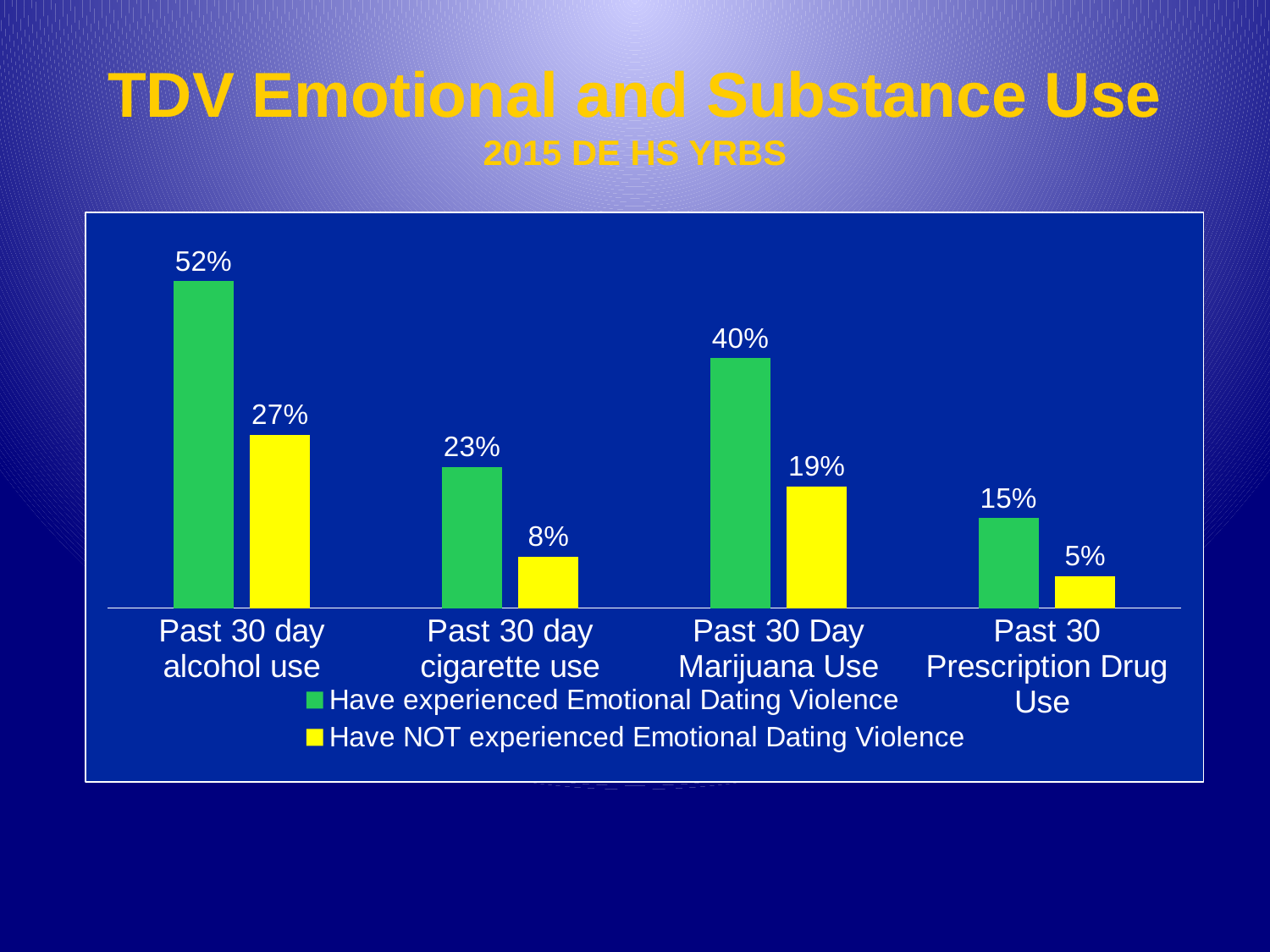
How many series does the legend list? 2 For Past 30 day cigarette use, which group has the larger value: those who have experienced Emotional Dating Violence or those who have NOT? Have experienced Emotional Dating Violence What is the value for Past 30 day cigarette use among those who have NOT experienced Emotional Dating Violence? 8% What is the difference between the two series for Past 30 Day Marijuana Use? 21% Which category has the lowest value for those who have NOT experienced Emotional Dating Violence? Past 30 Prescription Drug Use What is the value for Past 30 day alcohol use among those who have experienced Emotional Dating Violence? 52% What is the value for Past 30 Prescription Drug Use among those who have NOT experienced Emotional Dating Violence? 5% What is the value for Past 30 Day Marijuana Use among those who have experienced Emotional Dating Violence? 40% How many substance use categories are shown on the x axis? 4 Which category has the highest value for those who have experienced Emotional Dating Violence? Past 30 day alcohol use What is the difference between the two series for Past 30 day alcohol use? 25% What kind of chart is shown on the slide? Bar chart